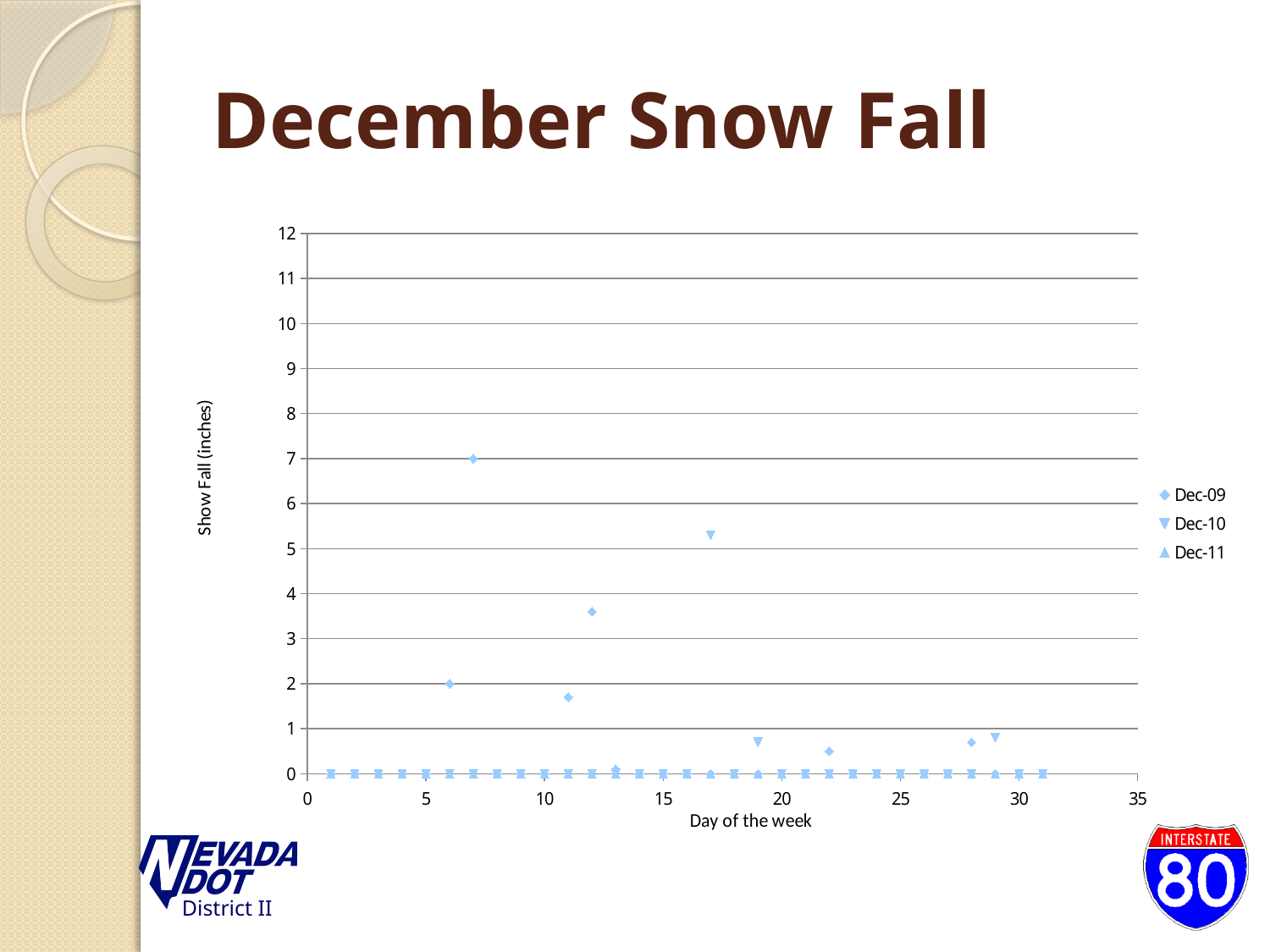
What is the snow fall value for Dec-09 on day 7? 7 Is the Dec-09 value on day 11 greater or less than 2? less What is the title of the x axis? Day of the week What is the snow fall value for Dec-09 on day 6? 2 How many series does the legend list? 3 On which day does the highest snow fall value occur? Day 7 Which is larger: the Dec-09 value on day 7 or the Dec-10 value on day 17? Dec-09 on day 7 What are the series names listed in the legend? Dec-09, Dec-10, Dec-11 Is the Dec-09 value on day 12 greater or less than 4? less Is the Dec-10 value on day 17 greater or less than 5? greater What kind of chart is shown on the slide? Scatter chart Which series contains the highest snow fall value on the chart? Dec-09